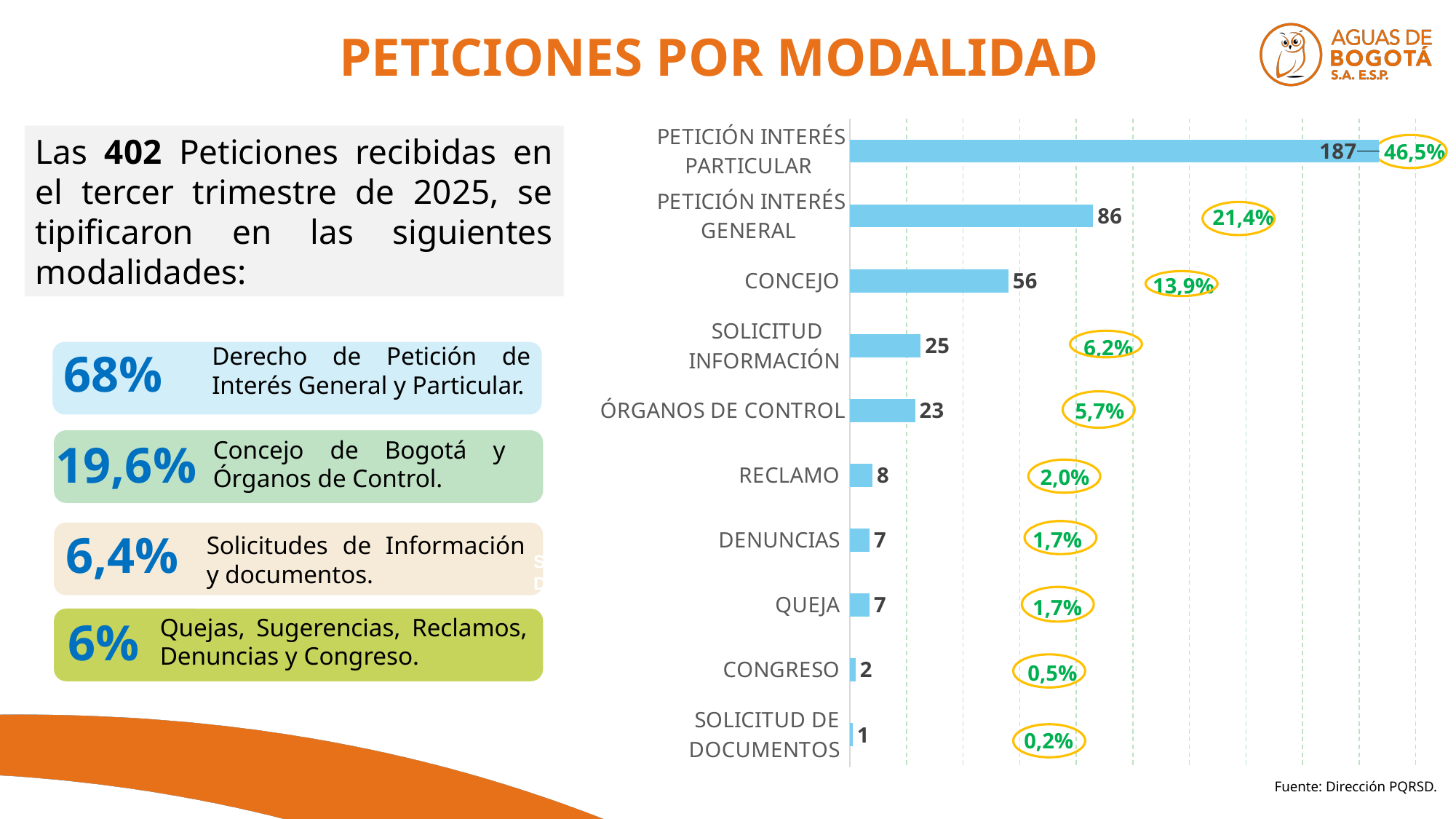
What is the title of the slide containing the chart? PETICIONES POR MODALIDAD What percentage is shown next to PETICIÓN INTERÉS GENERAL? 21,4% How many categories are shown in the chart? 10 What is the value for ÓRGANOS DE CONTROL? 23 Which category has the lowest value? SOLICITUD DE DOCUMENTOS What kind of chart is shown on the slide? Bar chart What is the difference between the values for RECLAMO and CONGRESO? 6 What is the difference between the values for PETICIÓN INTERÉS PARTICULAR and PETICIÓN INTERÉS GENERAL? 101 Which is larger, the value for SOLICITUD INFORMACIÓN or the value for ÓRGANOS DE CONTROL? SOLICITUD INFORMACIÓN Which category has the highest value? PETICIÓN INTERÉS PARTICULAR What is the value for CONCEJO? 56 What is the value for PETICIÓN INTERÉS PARTICULAR? 187